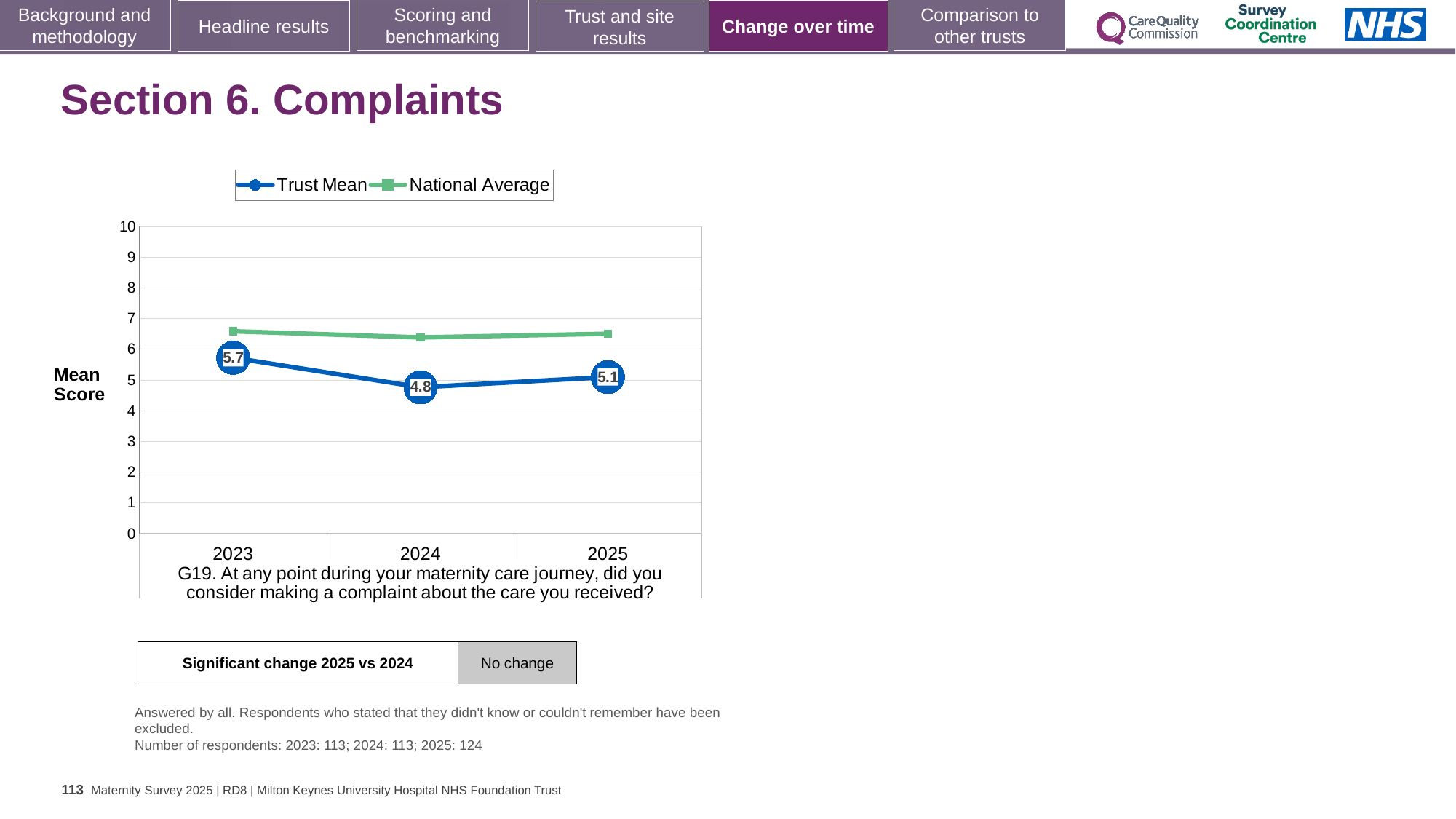
What is the difference between the Trust Mean scores for 2023 and 2024? 0.9 Which is higher in 2024, the Trust Mean or the National Average? National Average Is the National Average value for 2023 greater or less than 6? greater What kind of chart is shown on the slide? Line chart Does the Trust Mean rise or fall from 2023 to 2024? Fall What is the Trust Mean score for 2023? 5.7 In which year is the Trust Mean score lowest? 2024 How many years are plotted on the x axis? 3 What is the Trust Mean score for 2025? 5.1 What is the Trust Mean score for 2024? 4.8 In which year is the Trust Mean score highest? 2023 How many series does the legend list? 2